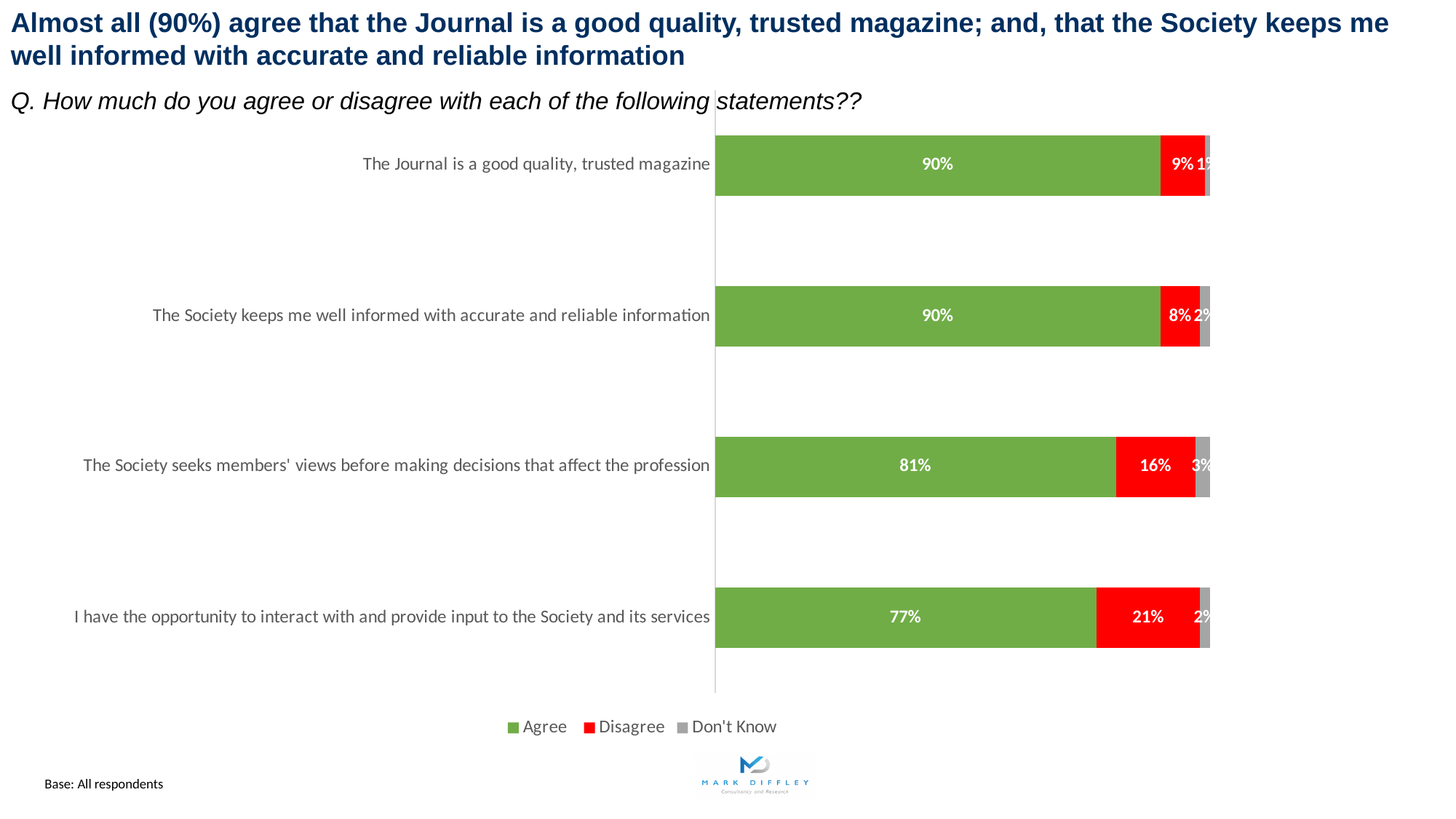
What percentage agree that the Journal is a good quality, trusted magazine? 90% What is the difference in Agree percentage between 'The Journal is a good quality, trusted magazine' and 'I have the opportunity to interact with and provide input to the Society and its services'? 13% How many statements are shown in the chart? 4 What is the Disagree value for 'The Society keeps me well informed with accurate and reliable information'? 8% Which has a higher Disagree percentage: 'The Society seeks members' views before making decisions that affect the profession' or 'The Society keeps me well informed with accurate and reliable information'? The Society seeks members' views before making decisions that affect the profession What percentage disagree that the Society seeks members' views before making decisions that affect the profession? 16% Which statement has the highest Disagree percentage? I have the opportunity to interact with and provide input to the Society and its services Which statement has the lowest Agree percentage? I have the opportunity to interact with and provide input to the Society and its services How many series does the legend list? 3 What is the Agree value for 'I have the opportunity to interact with and provide input to the Society and its services'? 77% Which colour represents the Disagree series in the chart? Red What kind of chart is shown on the slide? Stacked bar chart